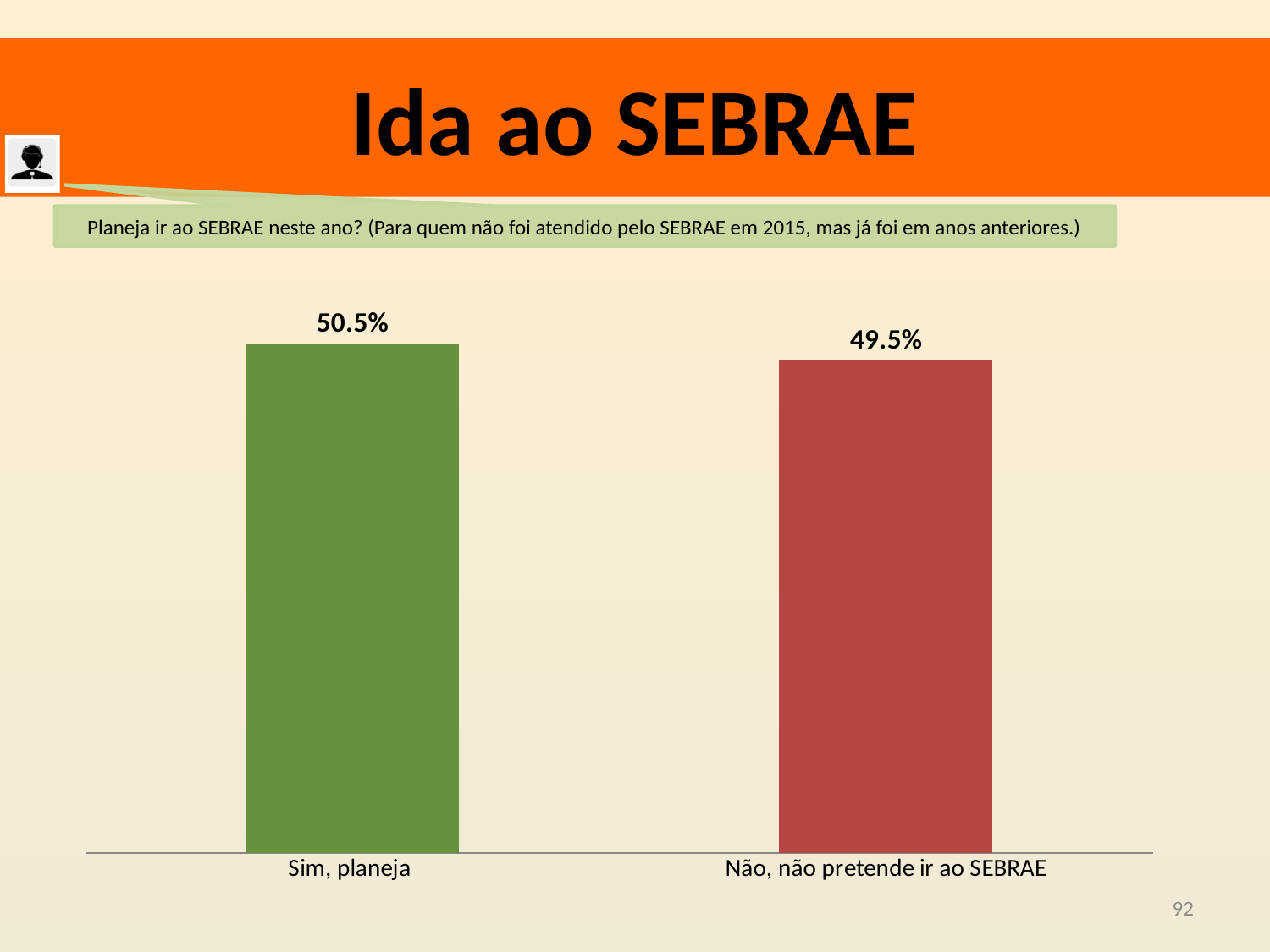
What colour is the bar for "Não, não pretende ir ao SEBRAE"? Red What kind of chart is shown on the slide? Bar chart How many categories are shown in the chart? 2 What is the total of the two values shown in the chart? 100.0% Which category has the lowest value? Não, não pretende ir ao SEBRAE What colour is the bar for "Sim, planeja"? Green Which category has the highest value? Sim, planeja What is the difference between the values for "Sim, planeja" and "Não, não pretende ir ao SEBRAE"? 1.0% What is the value for "Não, não pretende ir ao SEBRAE"? 49.5% What is the value for "Sim, planeja"? 50.5%